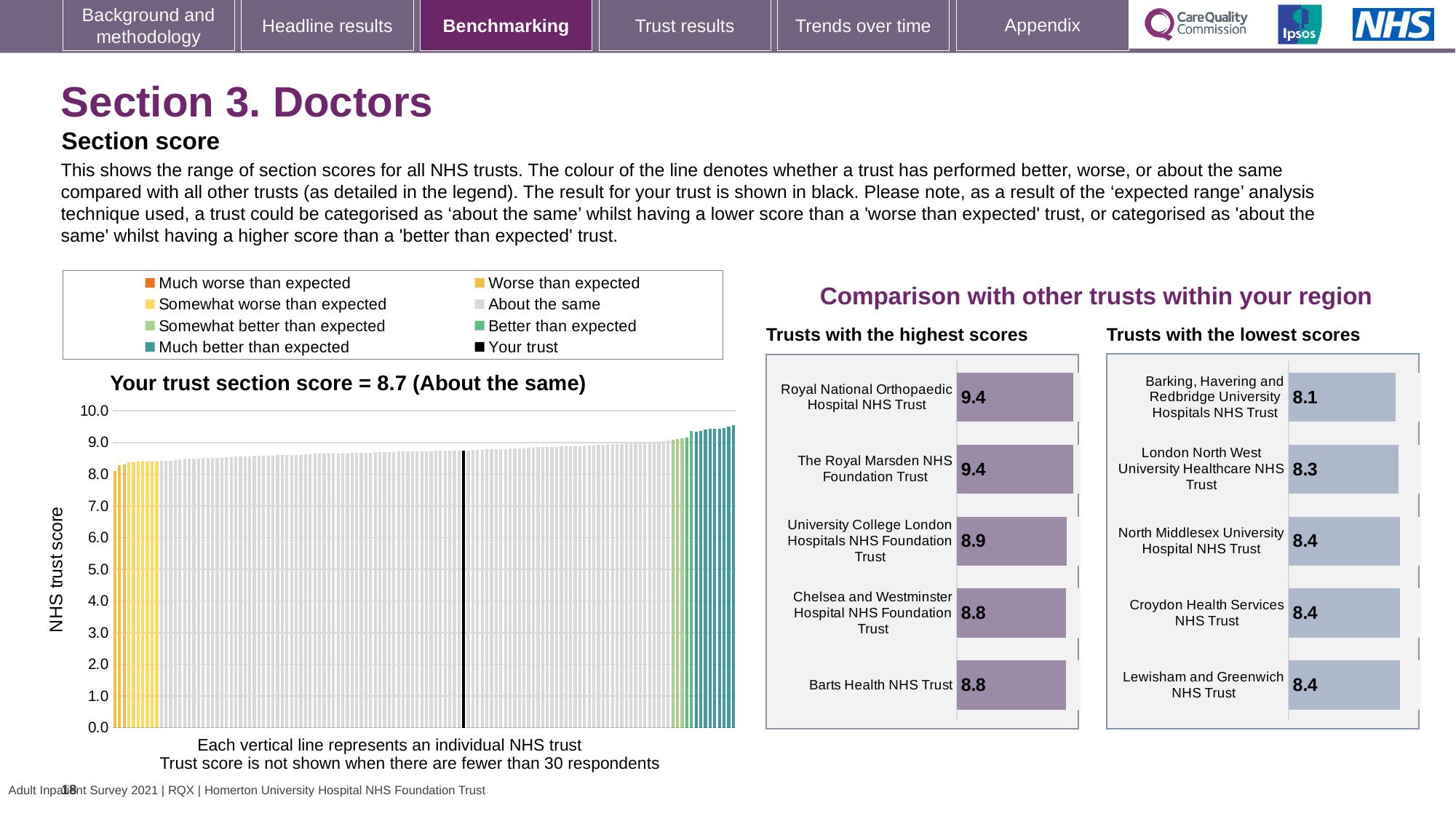
How many trusts are shown in the 'Trusts with the highest scores' chart? 5 What kind of chart is the 'Your trust section score' chart? bar chart How many entries does the legend above the 'Your trust section score' chart list? 8 In the 'Trusts with the highest scores' chart, what is the score for Barts Health NHS Trust? 8.8 In the 'Trusts with the highest scores' chart, what is the difference between the score for Royal National Orthopaedic Hospital NHS Trust and the score for Barts Health NHS Trust? 0.6 In the 'Trusts with the lowest scores' chart, which trust has the lowest score? Barking, Havering and Redbridge University Hospitals NHS Trust In the 'Your trust section score' chart, what is the section score for your trust? 8.7 In the 'Trusts with the highest scores' chart, what is the score for University College London Hospitals NHS Foundation Trust? 8.9 In the 'Trusts with the lowest scores' chart, what is the difference between the score for Lewisham and Greenwich NHS Trust and the score for Barking, Havering and Redbridge University Hospitals NHS Trust? 0.3 In the 'Trusts with the lowest scores' chart, which has the larger score: London North West University Healthcare NHS Trust or North Middlesex University Hospital NHS Trust? North Middlesex University Hospital NHS Trust In the 'Trusts with the lowest scores' chart, what is the score for London North West University Healthcare NHS Trust? 8.3 In the 'Your trust section score' chart, is the value for your trust greater or less than 8.0? greater